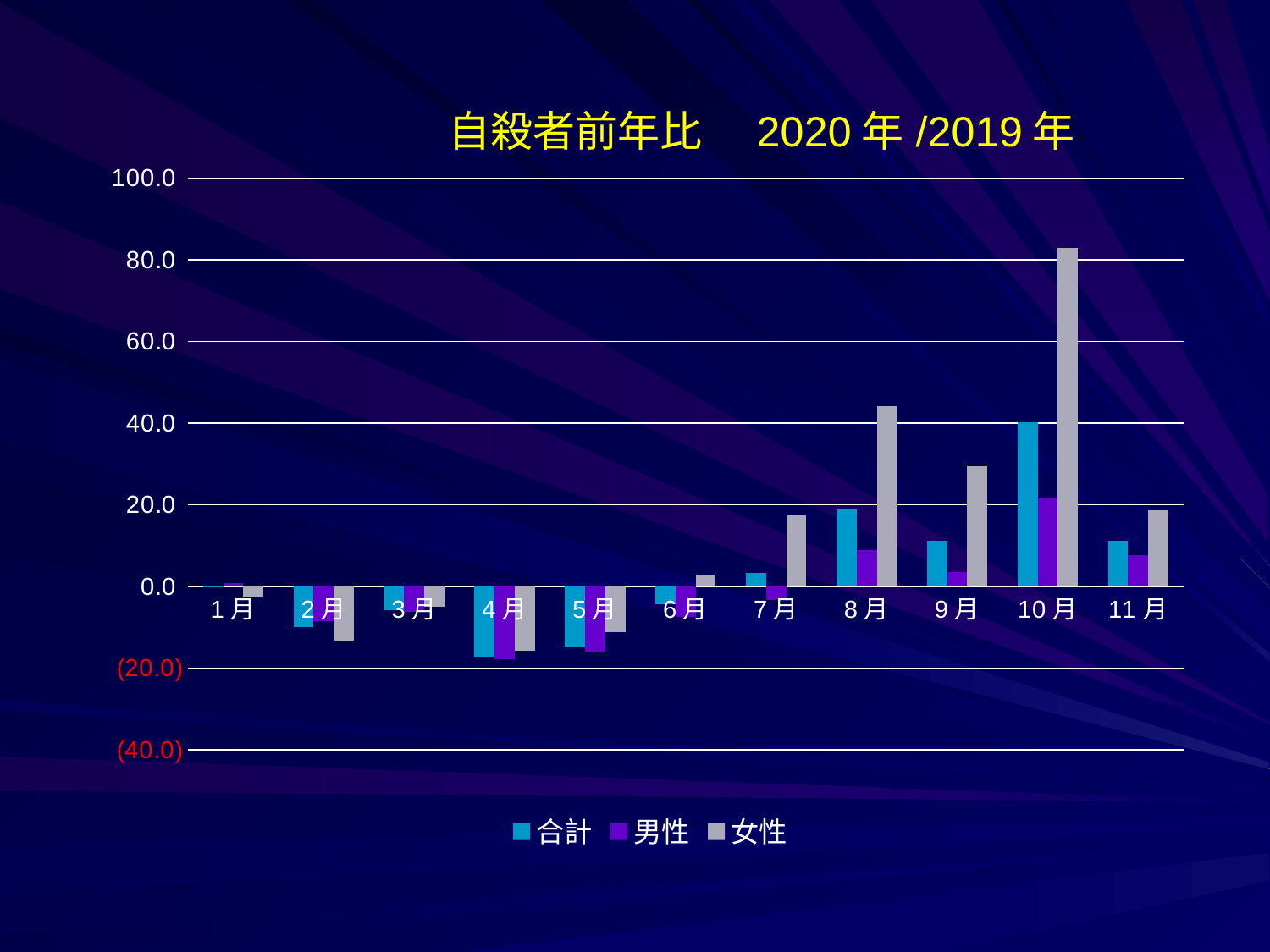
How many series does the legend list? 3 In which month is the 合計 value highest? 10月 Which is larger, the 合計 value for 10月 or the 合計 value for 9月? 10月 What is the title of the chart? 自殺者前年比 2020年/2019年 Which series is shown in grey in the legend? 女性 Is the 女性 value for 8月 greater or less than 40.0? greater Is the 女性 value for 10月 greater or less than 60.0? greater In which month is the 女性 value highest? 10月 Is the 合計 value for 4月 greater or less than 0.0? less What kind of chart is shown on the slide? bar chart How many months are shown on the x axis? 11 Which is larger, the 女性 value for 10月 or the 女性 value for 8月? 10月